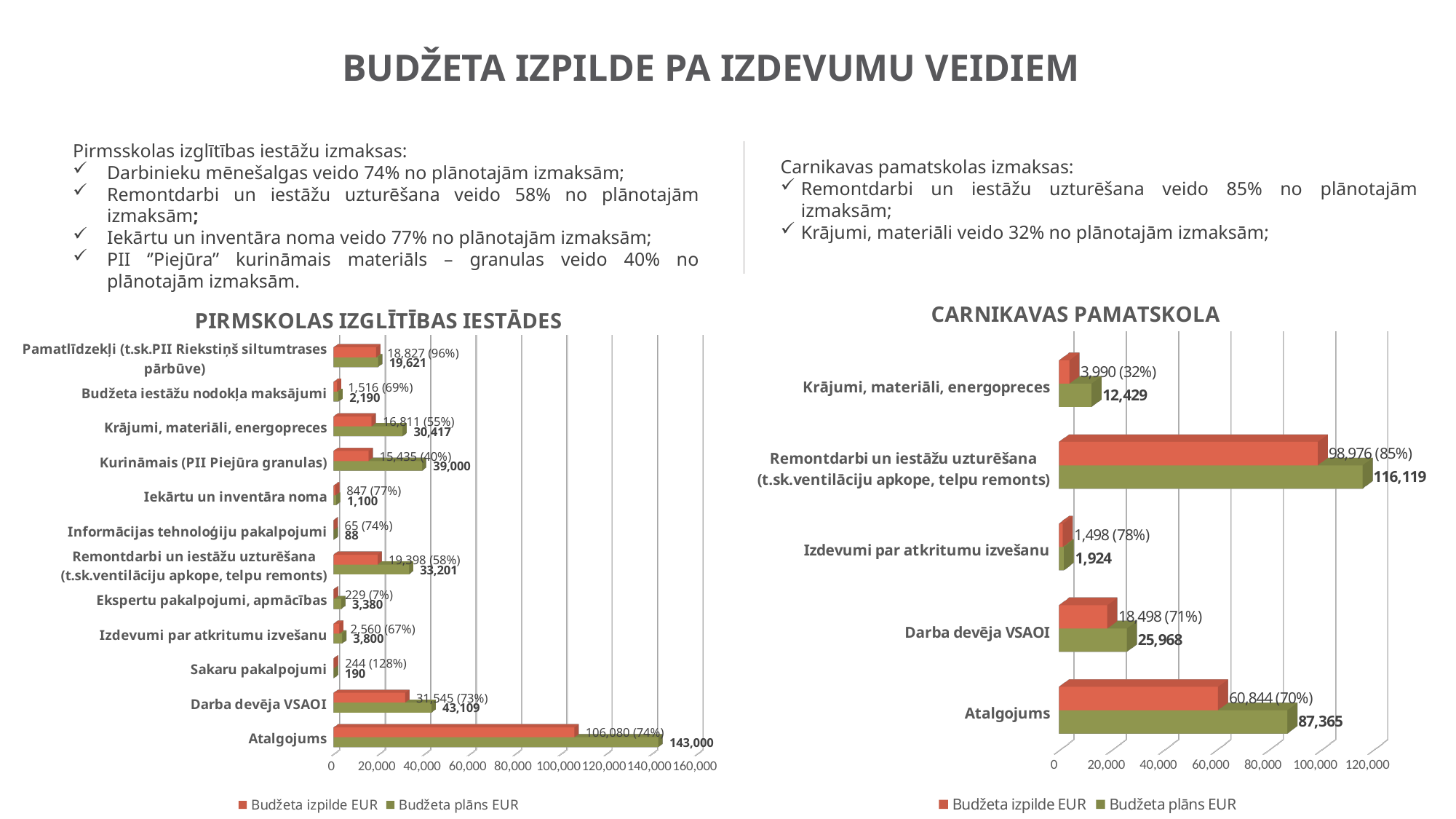
What kind of chart is the CARNIKAVAS PAMATSKOLA chart? Bar chart On the PIRMSKOLAS IZGLĪTĪBAS IESTĀDES chart, what is the Budžeta izpilde EUR value for Darba devēja VSAOI? 31,545 How many series does the legend of the PIRMSKOLAS IZGLĪTĪBAS IESTĀDES chart list? 2 On the CARNIKAVAS PAMATSKOLA chart, what is the difference between the Budžeta plāns EUR and Budžeta izpilde EUR values for Darba devēja VSAOI? 7,470 How many categories are shown on the PIRMSKOLAS IZGLĪTĪBAS IESTĀDES chart? 12 On the PIRMSKOLAS IZGLĪTĪBAS IESTĀDES chart, which category has the highest Budžeta plāns EUR value? Atalgojums On the CARNIKAVAS PAMATSKOLA chart, what is the Budžeta izpilde EUR value for Remontdarbi un iestāžu uzturēšana? 98,976 How many categories are shown on the CARNIKAVAS PAMATSKOLA chart? 5 On the CARNIKAVAS PAMATSKOLA chart, which category has the lowest Budžeta izpilde EUR value? Izdevumi par atkritumu izvešanu On the CARNIKAVAS PAMATSKOLA chart, what is the Budžeta plāns EUR value for Atalgojums? 87,365 On the PIRMSKOLAS IZGLĪTĪBAS IESTĀDES chart, what is the Budžeta plāns EUR value for Kurināmais (PII Piejūra granulas)? 39,000 On the PIRMSKOLAS IZGLĪTĪBAS IESTĀDES chart, which is larger for Sakaru pakalpojumi: Budžeta izpilde EUR or Budžeta plāns EUR? Budžeta izpilde EUR